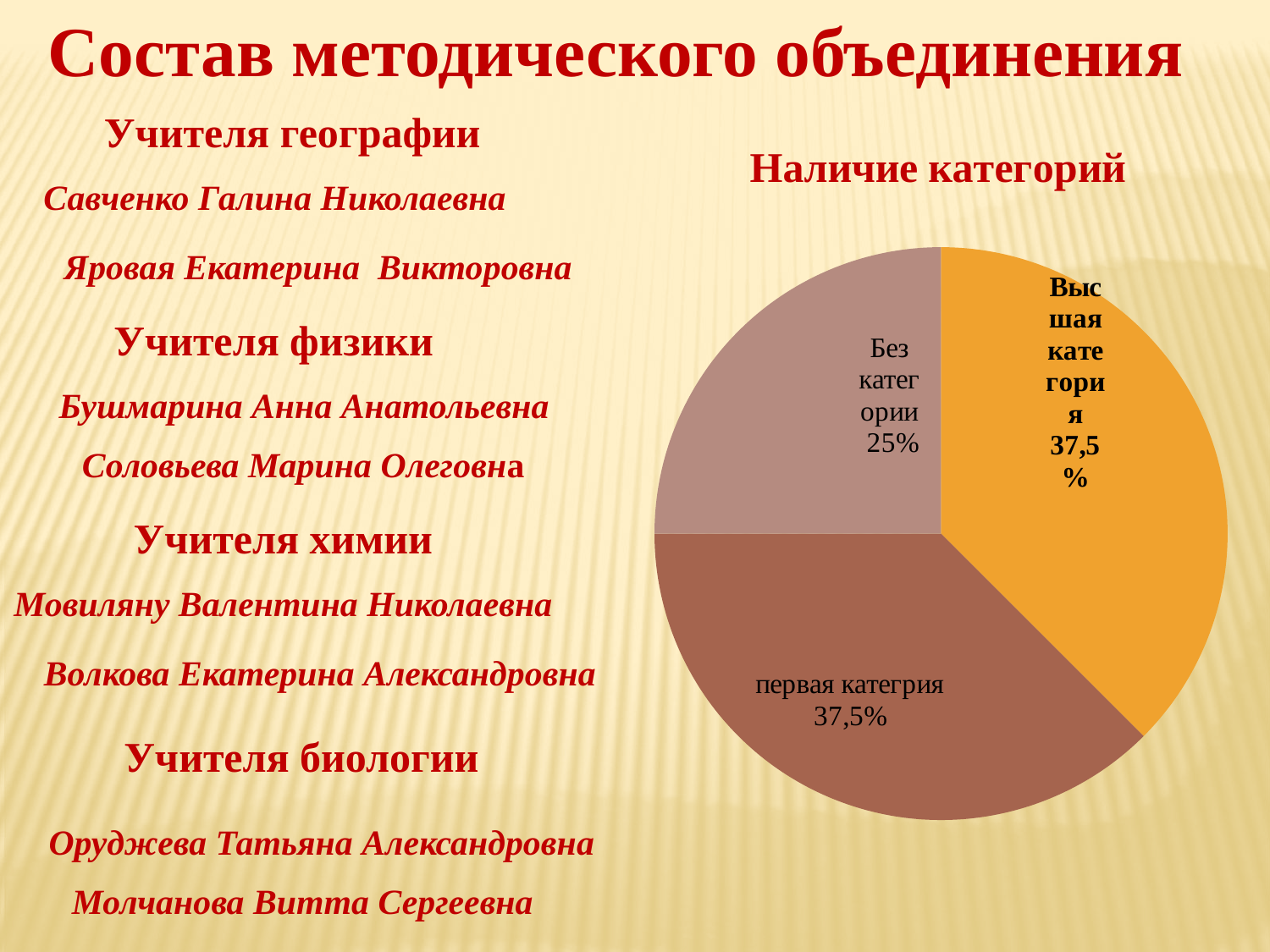
What is the combined share of the "Высшая категория" and "первая категрия" slices? 75% What type of chart is shown on the slide? pie chart Which is larger: the "Высшая категория" slice or the "Без категории" slice? Высшая категория How many slices does the pie chart have? 3 What share of the pie is labelled "Высшая категория"? 37,5% What share of the pie is labelled "первая категрия"? 37,5% What colour is the "Высшая категория" slice? orange What share of the pie is labelled "Без категории"? 25% Do the "Высшая категория" and "первая категрия" slices have the same share? yes What is the difference between the "первая категрия" share and the "Без категории" share? 12,5% What is the title of the chart? Наличие категорий Which slice of the pie chart is the smallest? Без категории